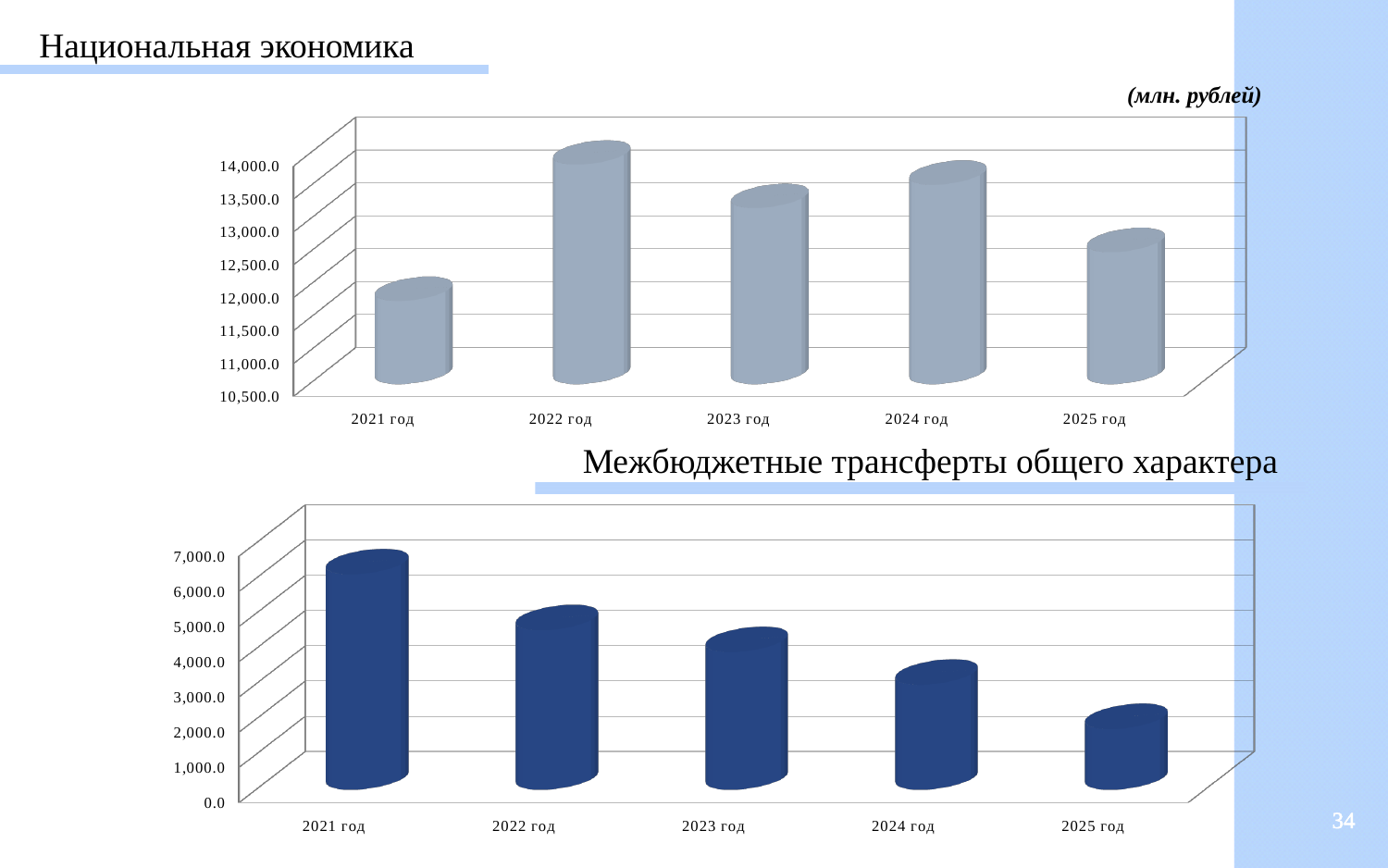
In the bottom chart "Межбюджетные трансферты общего характера", which year has the highest value? 2021 год In the top chart "Национальная экономика", is the value for 2022 год greater or less than 13,500.0? greater In the bottom chart "Межбюджетные трансферты общего характера", do the values rise or fall from 2021 год to 2025 год? fall In the top chart "Национальная экономика", which year has the lowest value? 2021 год In the bottom chart "Межбюджетные трансферты общего характера", which year has the lowest value? 2025 год What kind of chart is the top chart titled "Национальная экономика"? bar chart In the top chart "Национальная экономика", is the value for 2021 год greater or less than 12,500.0? less In the bottom chart "Межбюджетные трансферты общего характера", is the value for 2025 год greater or less than 3,000.0? less In the top chart "Национальная экономика", which year has the highest value? 2022 год How many years are shown on the x axis of the bottom chart "Межбюджетные трансферты общего характера"? 5 In the bottom chart "Межбюджетные трансферты общего характера", which is larger, the value for 2022 год or the value for 2024 год? 2022 год What unit of measurement is stated above the top chart "Национальная экономика"? млн. рублей